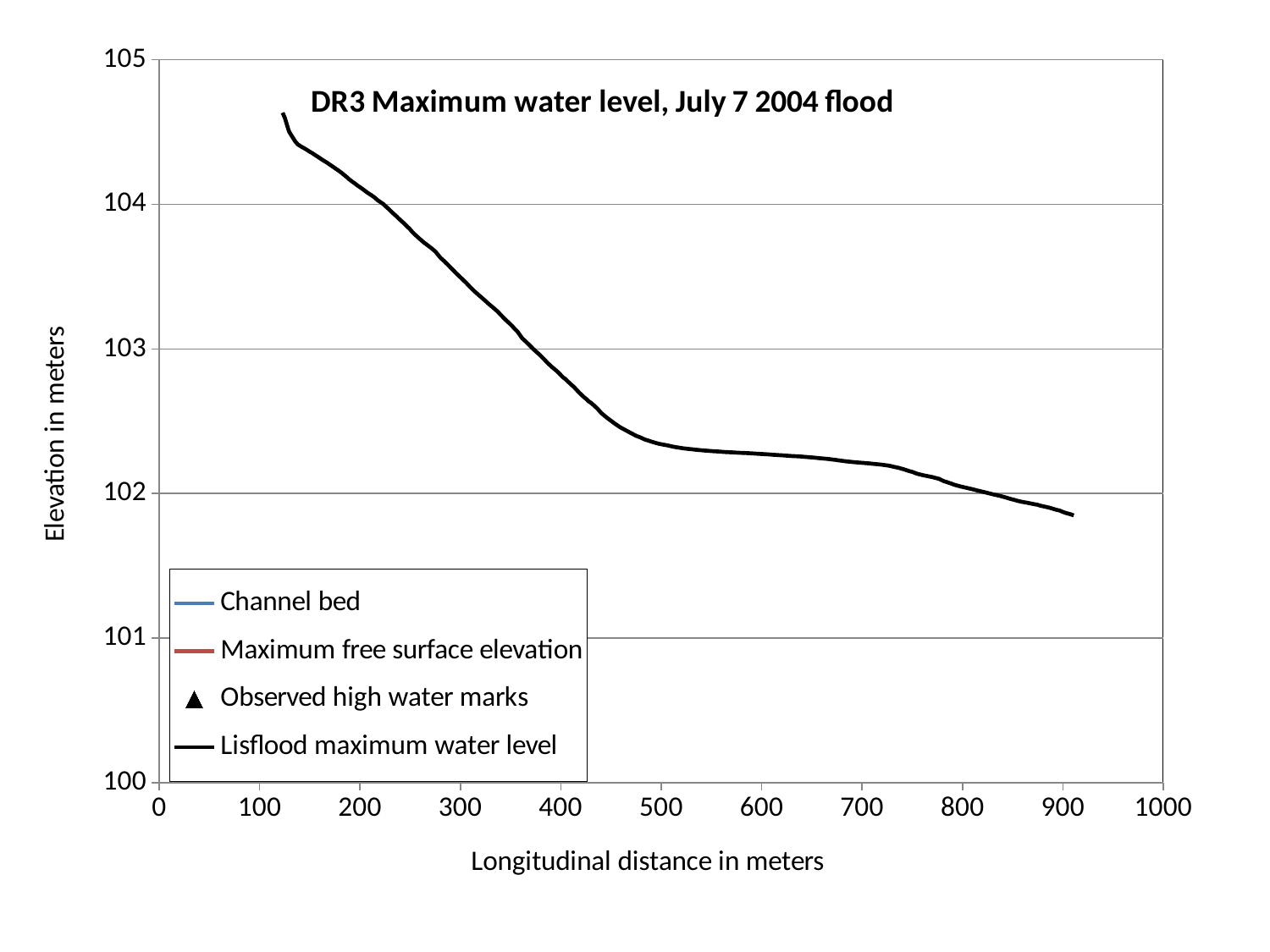
Is the Lisflood maximum water level at a longitudinal distance of 150 meters greater or less than 104? greater Is the Lisflood maximum water level at a longitudinal distance of 900 meters greater or less than 102? less What is the title of the chart? DR3 Maximum water level, July 7 2004 flood Is the Lisflood maximum water level at a longitudinal distance of 300 meters greater or less than 103? greater Which is larger, the Lisflood maximum water level at 200 meters or at 800 meters? 200 meters Does the Lisflood maximum water level rise or fall as longitudinal distance increases? fall Which is larger, the Lisflood maximum water level at 600 meters or at 300 meters? 300 meters What kind of chart is shown on the slide? line chart What is the label of the y axis? Elevation in meters How many series does the legend list? 4